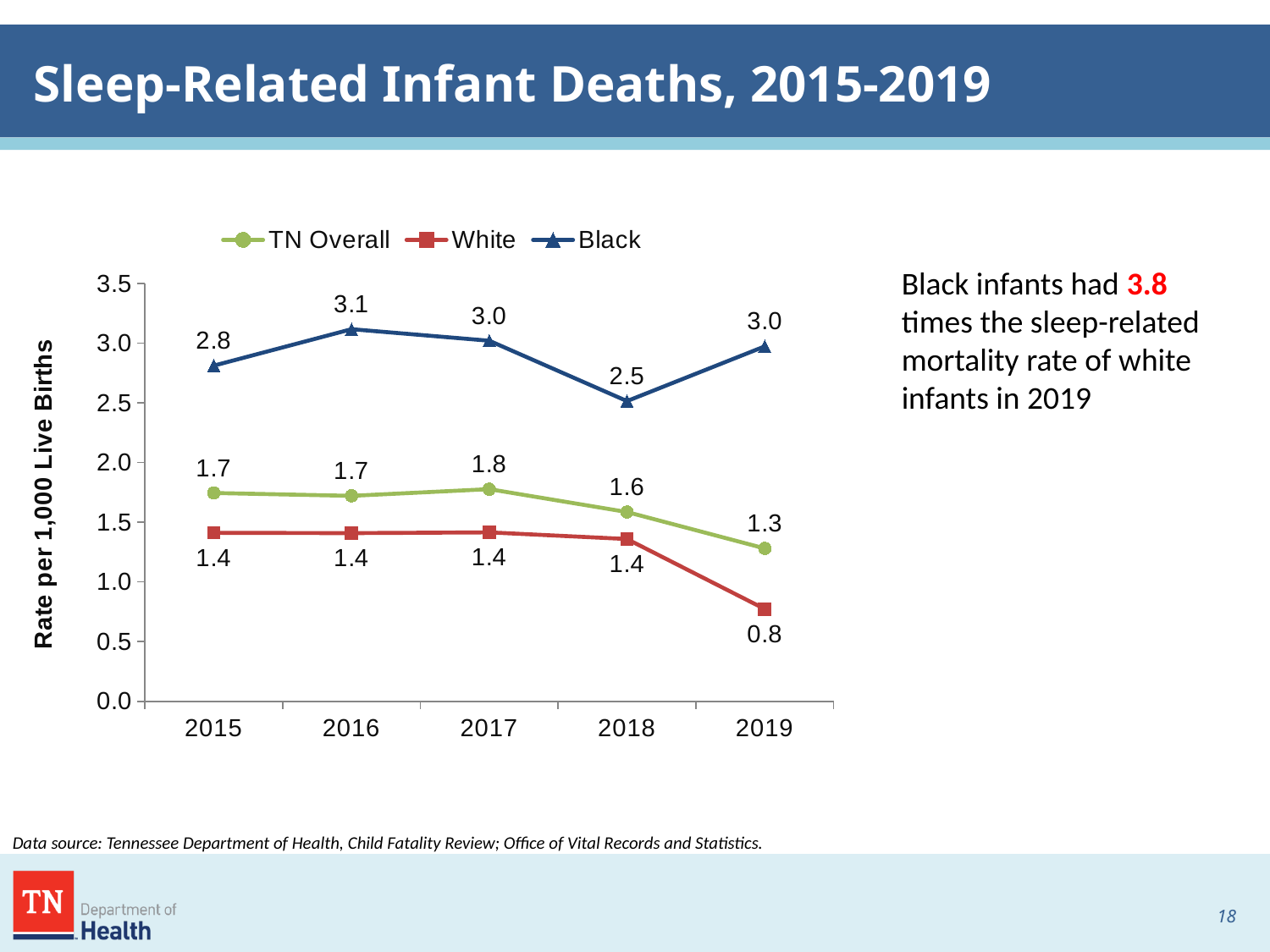
What was the sleep-related infant death rate for White infants in 2019? 0.8 How many years are shown on the x axis? 5 What is the label of the y axis? Rate per 1,000 Live Births In which year was the Black infant sleep-related death rate lowest? 2018 What is the difference between the Black and White sleep-related infant death rates in 2019? 2.2 What was the TN Overall sleep-related infant death rate in 2017? 1.8 What was the sleep-related infant death rate for Black infants in 2016? 3.1 Did the White infant sleep-related death rate rise or fall from 2018 to 2019? Fall How many series does the legend list? 3 What kind of chart is shown on the slide? Line chart Which series had the higher rate in 2018, TN Overall or White? TN Overall In which year was the Black infant sleep-related death rate highest? 2016